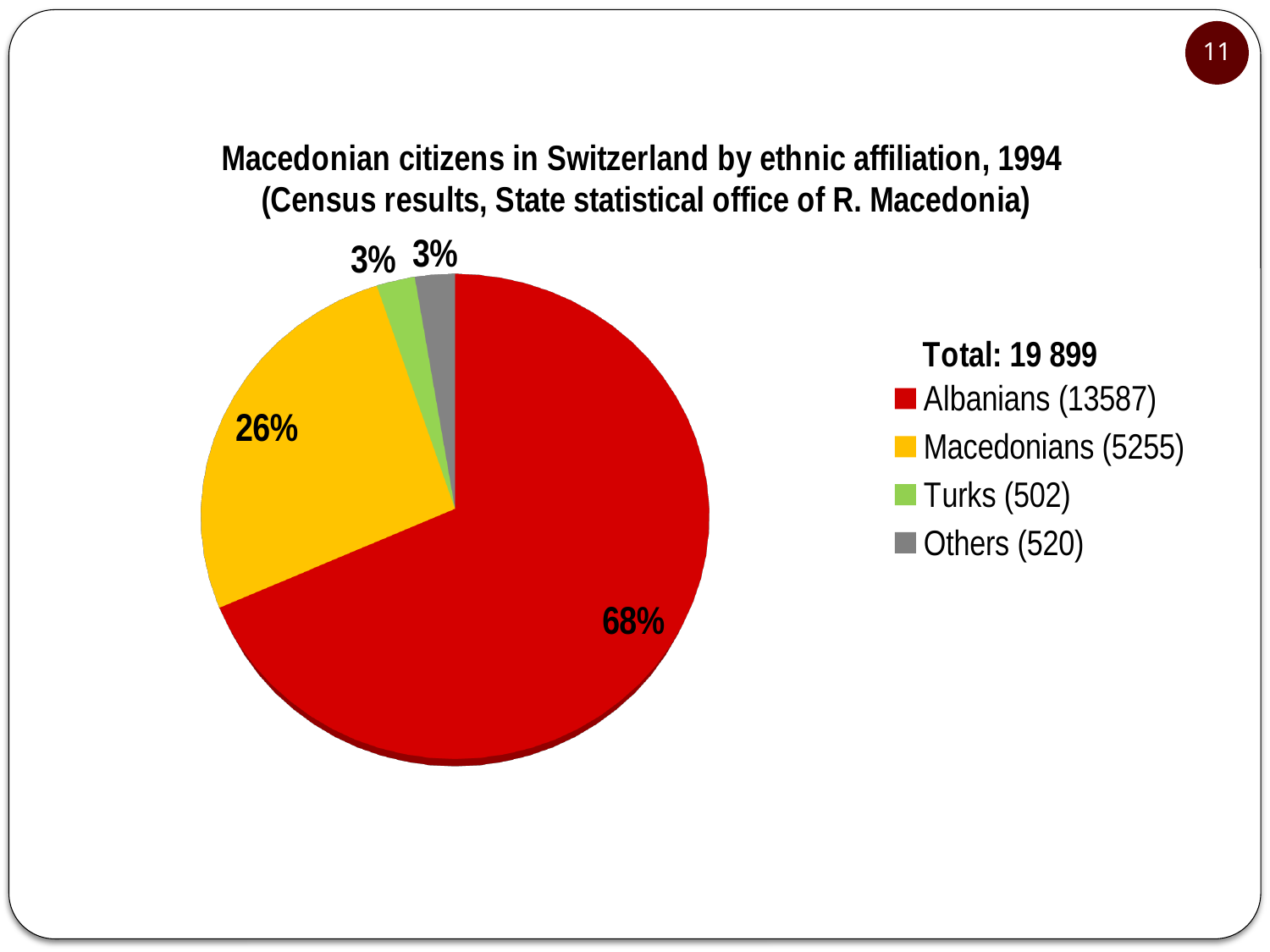
How many entries does the legend list? 4 What percentage share of the pie do Macedonians have? 26% What total is stated next to the legend? 19 899 What percentage share of the pie do Albanians have? 68% Which is larger, the share for Macedonians or the share for Turks? Macedonians What is the number of Macedonians shown in the legend? 5255 What is the difference in percentage points between the Albanians' share and the Macedonians' share? 42 What is the number of Albanians shown in the legend? 13587 How many slices does the pie chart have? 4 What percentage share of the pie do Turks have? 3% Which ethnic group has the largest slice of the pie? Albanians What kind of chart is shown on the slide? pie chart